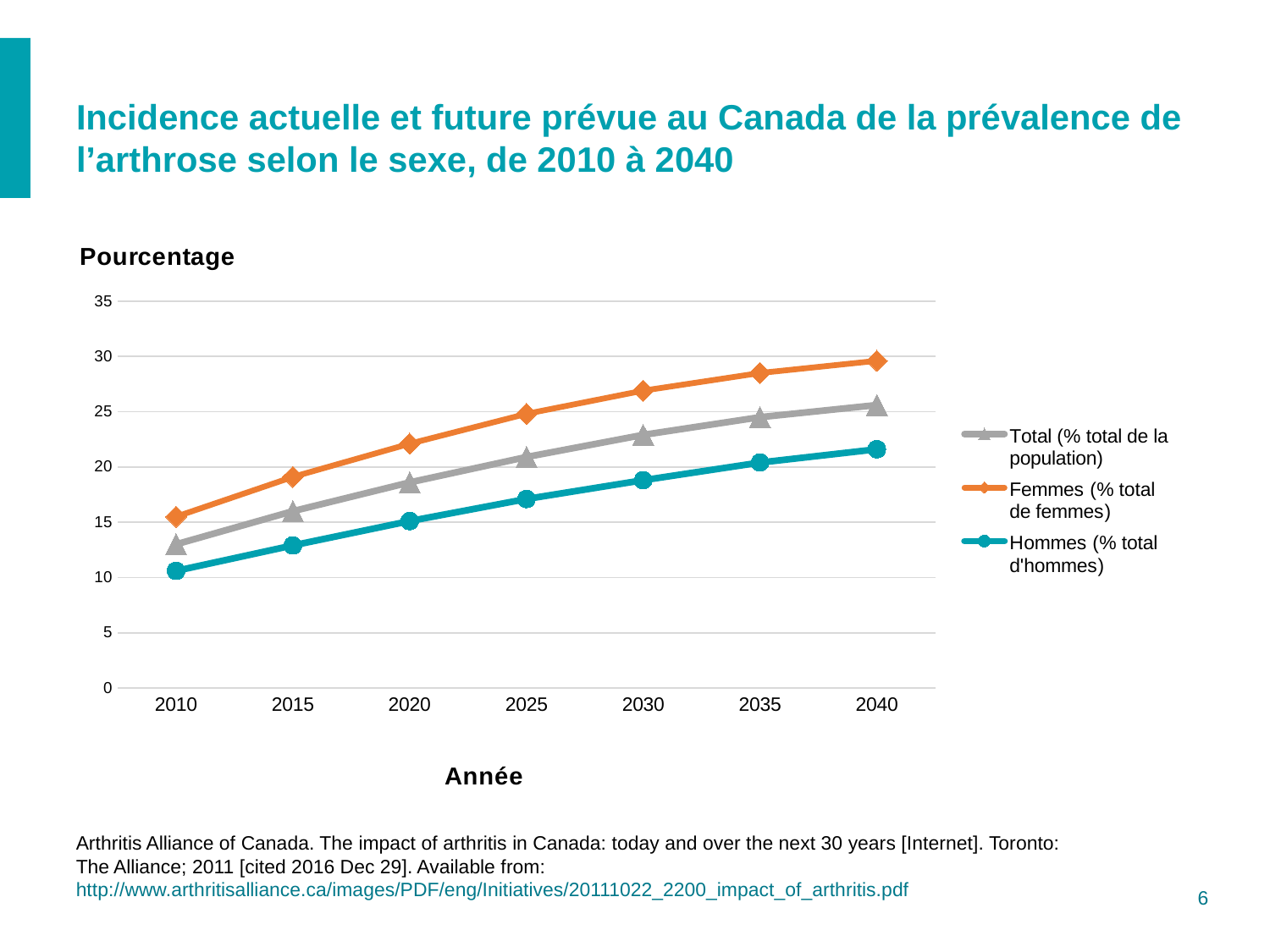
Is the value for Femmes (% total de femmes) in 2035 greater or less than 30? less How many years are plotted along the x axis? 7 Which series has the highest values across all years? Femmes (% total de femmes) What is the title of the horizontal axis? Année Is the value for Total (% total de la population) in 2010 greater or less than 15? less How many series does the legend list? 3 What is the title of the vertical axis? Pourcentage Is the value for Hommes (% total d'hommes) in 2040 greater or less than 20? greater Which series has the lowest values across all years? Hommes (% total d'hommes) In 2040, which is larger: the value for Femmes (% total de femmes) or for Hommes (% total d'hommes)? Femmes (% total de femmes) Do the values for Femmes (% total de femmes) rise or fall from 2010 to 2040? Rise What kind of chart is shown on the slide? Line chart